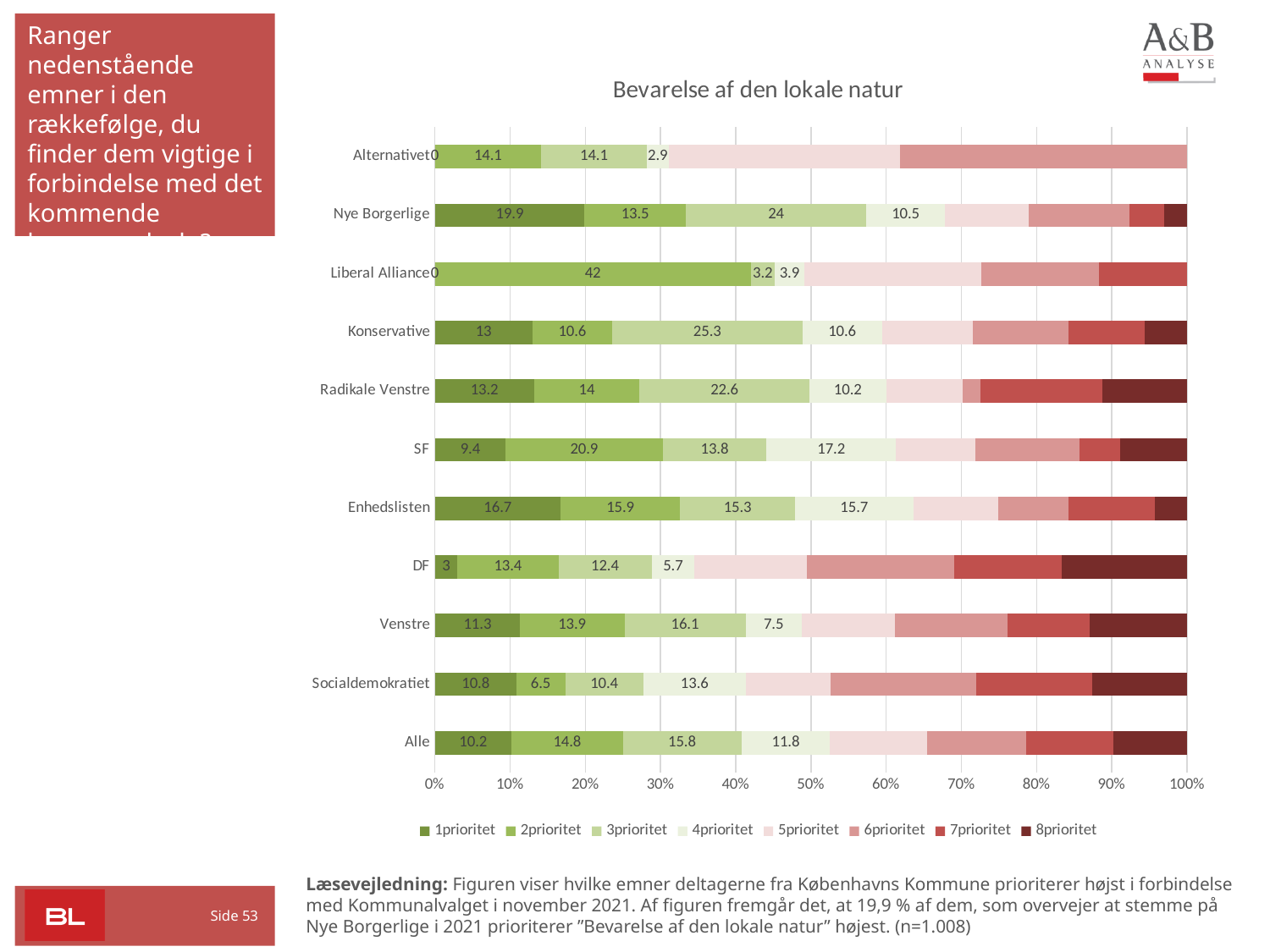
How many series does the legend list? 8 What is the 2prioritet value for Liberal Alliance? 42 What is the 4prioritet value for SF? 17.2 Which is larger, the 3prioritet value for Radikale Venstre or for Venstre? Radikale Venstre How many categories (parties) are shown on the y axis? 11 What is the 3prioritet value for Konservative? 25.3 What is the difference between the 1prioritet values for Enhedslisten and DF? 13.7 What is the 1prioritet value for Nye Borgerlige? 19.9 Which category has the lowest 2prioritet value? Socialdemokratiet Which party has the highest 1prioritet value? Nye Borgerlige What is the 1prioritet value for Alle? 10.2 What kind of chart is shown on the slide? Stacked bar chart